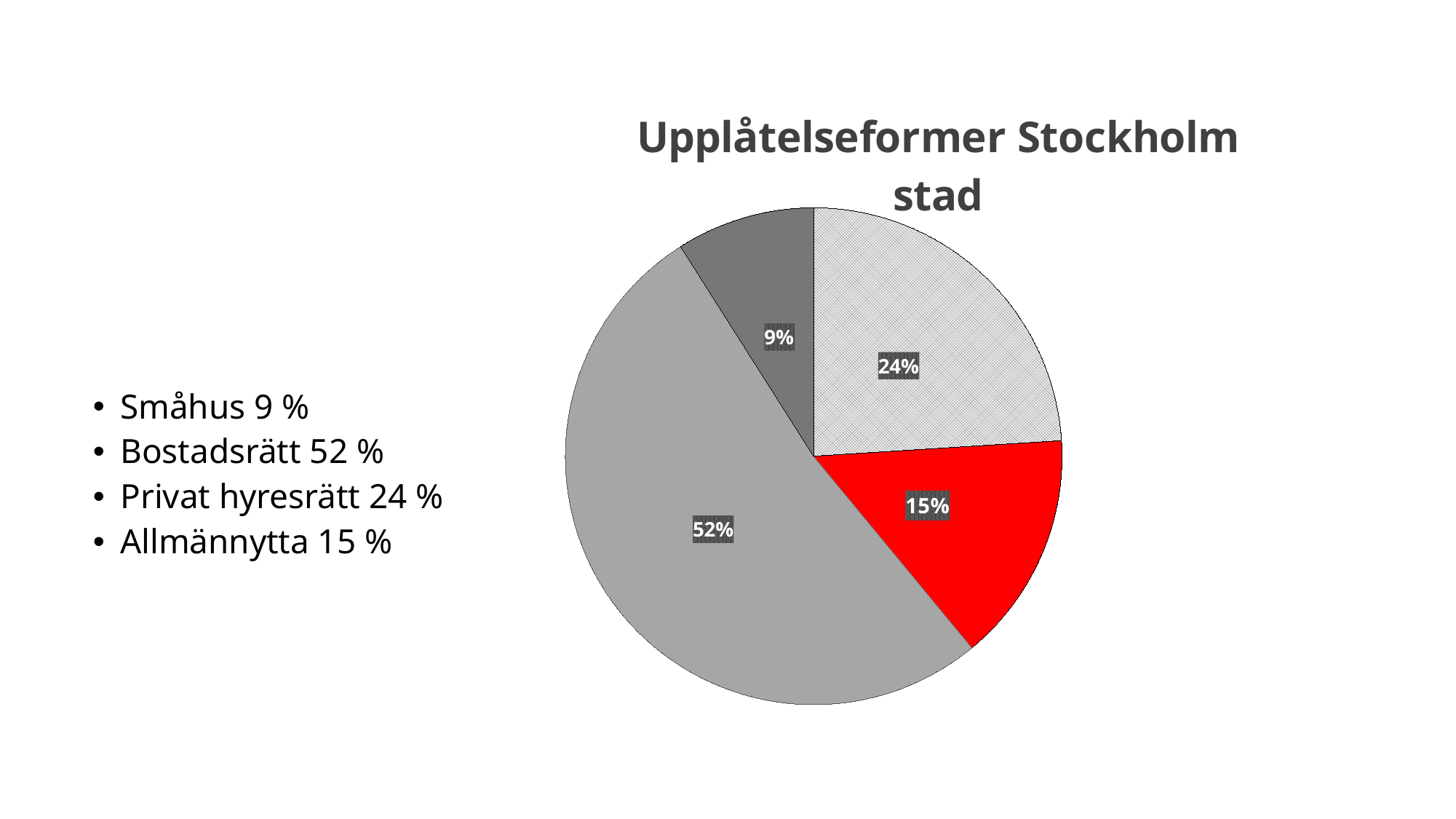
Which category has the largest slice of the pie? Bostadsrätt According to the slide, what is the share for Privat hyresrätt? 24% What kind of chart is shown on the slide? pie chart What share of the pie is labelled 52%, and which category does the slide text say it corresponds to? Bostadsrätt What is the title of the chart? Upplåtelseformer Stockholm stad What colour is the slice labelled 15%? red According to the slide, what is the share for Småhus? 9% What is the difference in percentage points between the Bostadsrätt slice and the Privat hyresrätt slice? 28 Which is larger, the Allmännytta slice or the Privat hyresrätt slice? Privat hyresrätt How many slices does the pie chart have? 4 Which category has the smallest slice of the pie? Småhus According to the slide, what is the share for Allmännytta? 15%